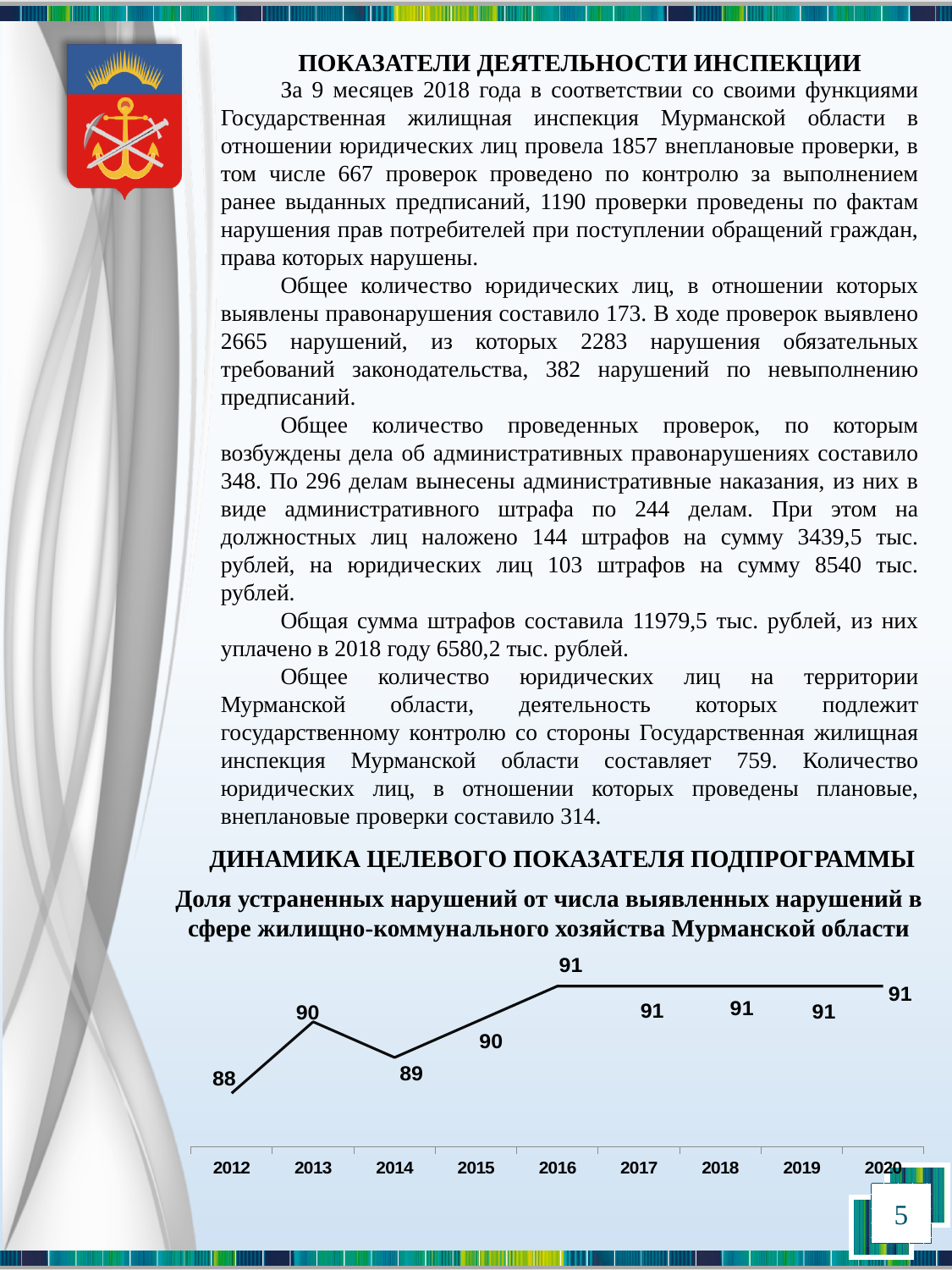
How many years are plotted on the x axis of the chart? 9 Which year has the lowest value on the chart? 2012 What is the difference between the values for 2013 and 2012? 2 What is the value for 2012 on the chart? 88 What is the value for 2014 on the chart? 89 What is the title of the chart? Доля устраненных нарушений от числа выявленных нарушений в сфере жилищно-коммунального хозяйства Мурманской области Which is larger, the value for 2013 or the value for 2014? 2013 What is the value for 2016 on the chart? 91 What is the value for 2020 on the chart? 91 What type of chart is shown on the slide? line chart What is the difference between the values for 2016 and 2014? 2 Do the values generally rise or fall from 2012 to 2020? rise